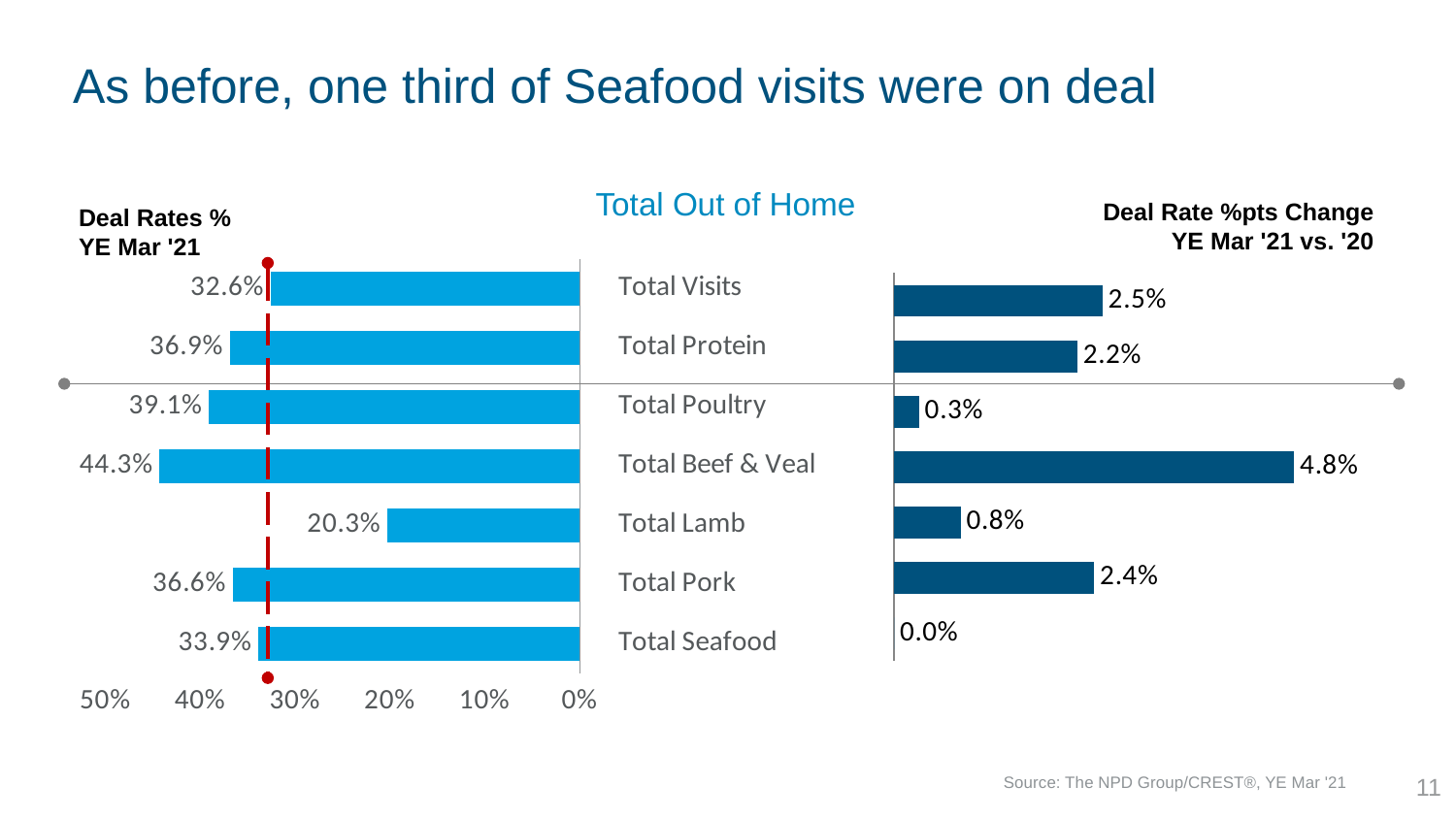
In the Deal Rate %pts Change YE Mar '21 vs. '20 chart, which is larger, the value for Total Visits or Total Protein? Total Visits What type of chart is the Deal Rate %pts Change YE Mar '21 vs. '20 chart? Bar chart In the Deal Rates % YE Mar '21 chart, which category has the lowest deal rate? Total Lamb In the Deal Rates % YE Mar '21 chart, what is the difference between the deal rates for Total Poultry and Total Visits? 6.5% In the Deal Rates % YE Mar '21 chart, what is the deal rate for Total Beef & Veal? 44.3% In the Deal Rate %pts Change YE Mar '21 vs. '20 chart, which category has the largest change? Total Beef & Veal In the Deal Rates % YE Mar '21 chart, which category has the highest deal rate? Total Beef & Veal In the Deal Rate %pts Change YE Mar '21 vs. '20 chart, what is the value for Total Seafood? 0.0% In the Deal Rate %pts Change YE Mar '21 vs. '20 chart, what is the value for Total Pork? 2.4% In the Deal Rates % YE Mar '21 chart, what is the deal rate for Total Seafood? 33.9% In the Deal Rate %pts Change YE Mar '21 vs. '20 chart, what is the difference between the values for Total Beef & Veal and Total Poultry? 4.5% How many categories are shown in the Deal Rates % YE Mar '21 chart? 7